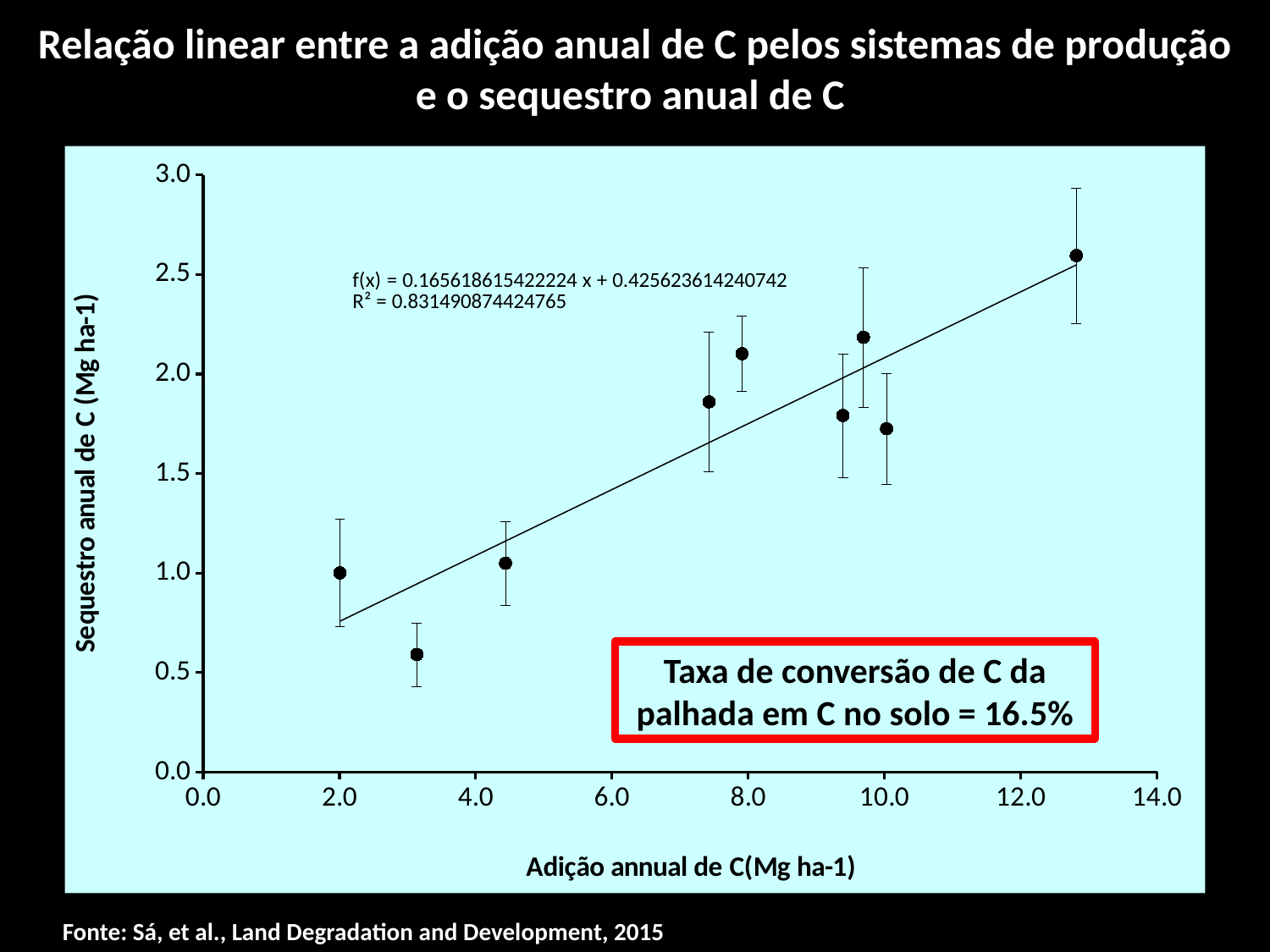
Do the values of Sequestro anual de C generally rise or fall as Adição annual de C increases? Rise What is the R² value printed on the chart? 0.831490874424765 What kind of chart is shown on the slide? Scatter plot Is the value of Sequestro anual de C for the point at about 12.8 on the x axis greater or less than 2.5? greater What is the maximum value shown on the x axis? 14.0 What is the slope of the fitted line f(x) shown on the chart? 0.165618615422224 Which point has the highest Sequestro anual de C: the one at about 8.0 on the x axis or the one at about 10.0? The one at about 8.0 How many data points are plotted on the chart? 9 What is the title of the y axis? Sequestro anual de C (Mg ha-1) Is the value of Sequestro anual de C for the point at about 3.1 on the x axis greater or less than 1.0? less What is the intercept of the fitted line f(x) shown on the chart? 0.425623614240742 What conversion rate of straw C to soil C is stated in the red box on the chart? 16.5%